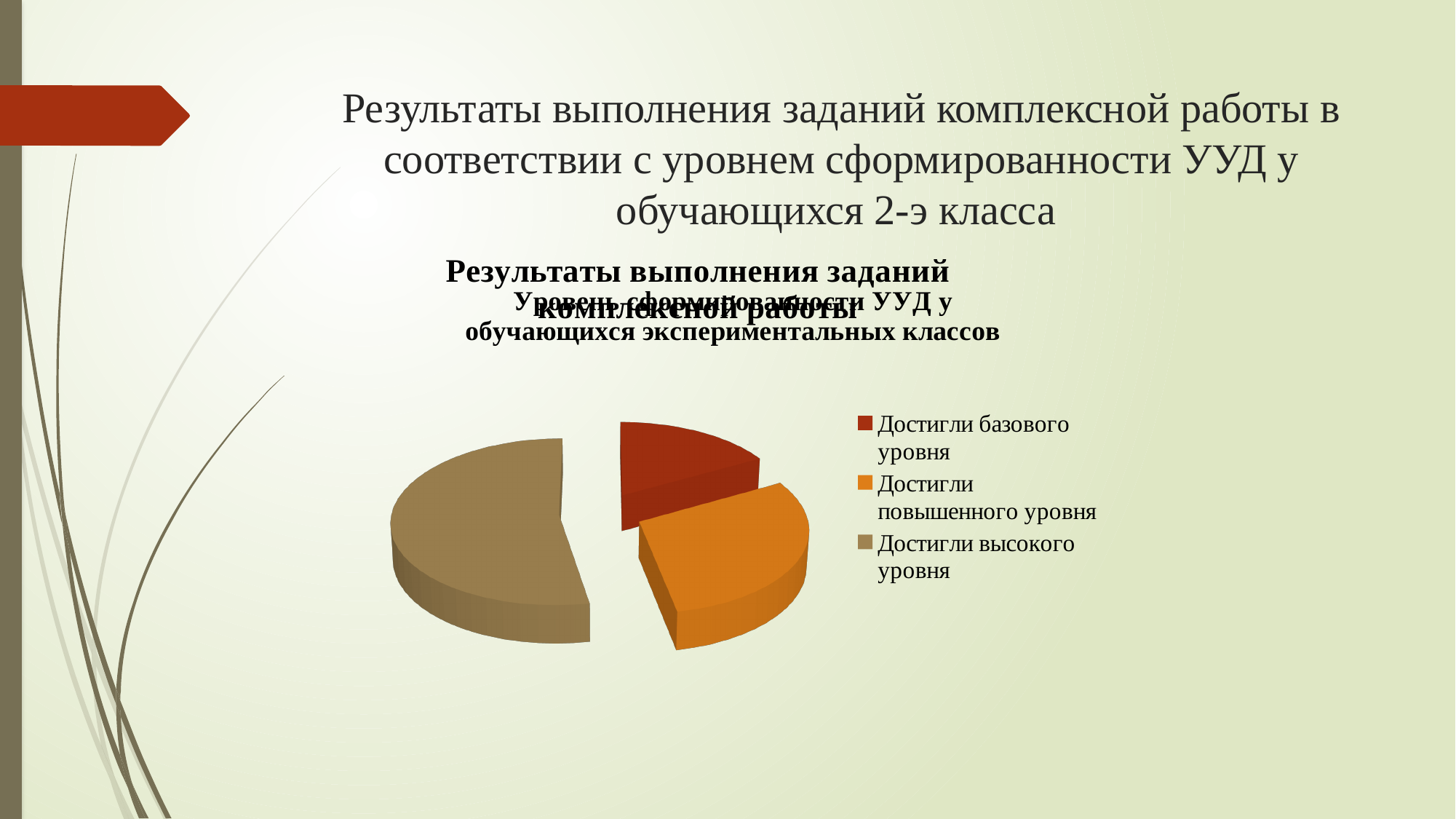
What kind of chart is shown on the slide? pie chart Which category has the smallest slice in the pie chart? Достигли базового уровня What colour is the slice for "Достигли базового уровня" in the pie chart? dark red How many entries does the legend of the pie chart list? 3 Which category has the largest slice in the pie chart? Достигли высокого уровня Which slice is larger: "Достигли высокого уровня" or "Достигли повышенного уровня"? Достигли высокого уровня What colour is the slice for "Достигли повышенного уровня" in the pie chart? orange Which slice is larger: "Достигли повышенного уровня" or "Достигли базового уровня"? Достигли повышенного уровня How many slices does the pie chart have? 3